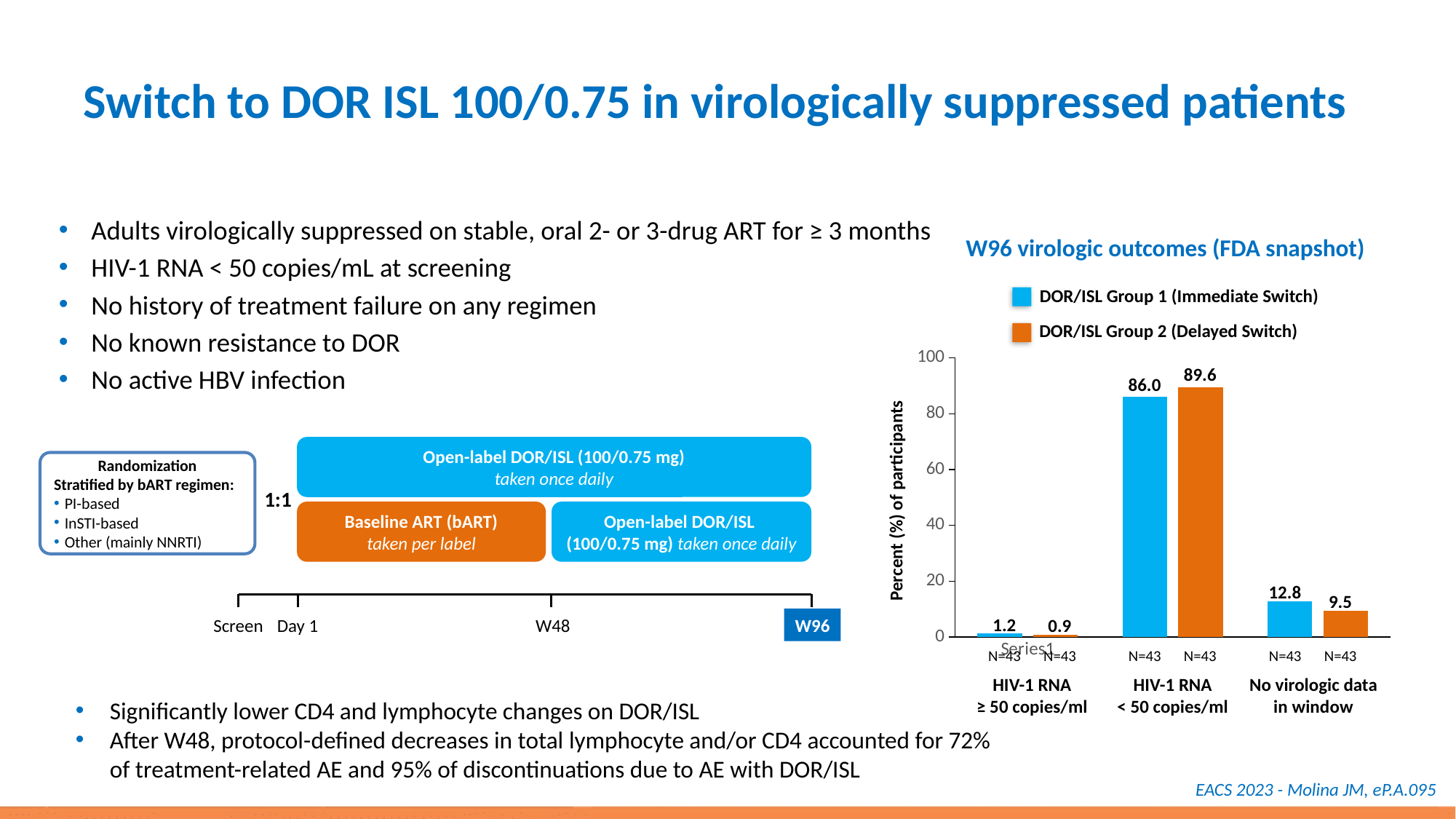
What is the value for DOR/ISL Group 2 (Delayed Switch) in the HIV-1 RNA ≥ 50 copies/ml category? 0.9 What type of chart is used to show the W96 virologic outcomes? Bar chart How many categories are shown on the x axis of the chart? 3 How many series does the chart legend list? 2 Which category has the highest value for DOR/ISL Group 1 (Immediate Switch)? HIV-1 RNA < 50 copies/ml What is the value for DOR/ISL Group 1 (Immediate Switch) in the No virologic data in window category? 12.8 What is the difference between the two groups in the HIV-1 RNA < 50 copies/ml category? 3.6 What is the value for DOR/ISL Group 2 (Delayed Switch) in the HIV-1 RNA < 50 copies/ml category? 89.6 In the No virologic data in window category, which group has the larger value? DOR/ISL Group 1 (Immediate Switch) What is the value for DOR/ISL Group 1 (Immediate Switch) in the HIV-1 RNA < 50 copies/ml category? 86.0 Is the value for DOR/ISL Group 2 (Delayed Switch) in the HIV-1 RNA < 50 copies/ml category greater or less than 80? greater Which category has the lowest value for DOR/ISL Group 2 (Delayed Switch)? HIV-1 RNA ≥ 50 copies/ml